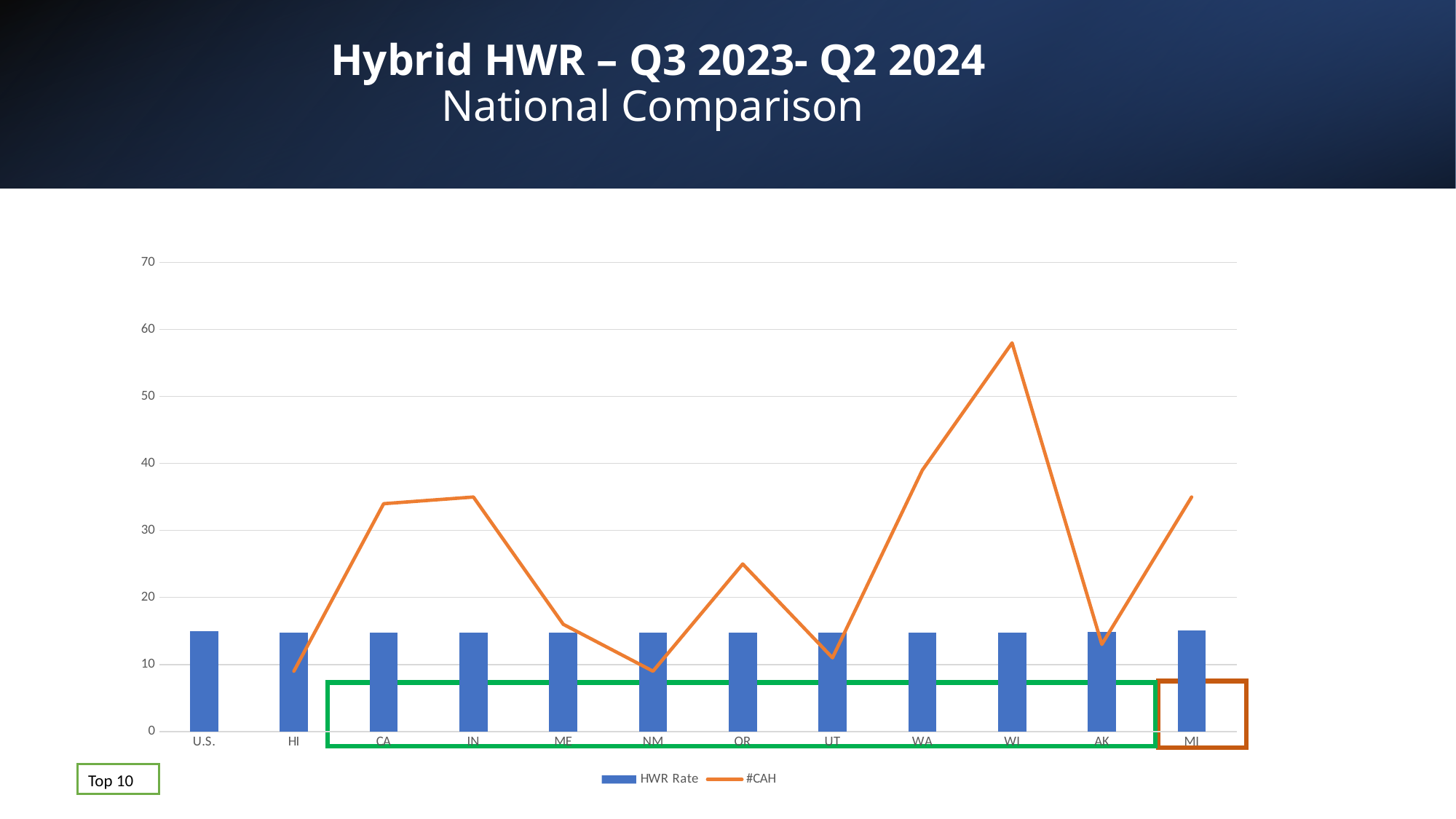
Is the #CAH value for CA greater or less than 30? greater Is the #CAH value for AK greater or less than 20? less What kind of chart is shown on the slide? A combination bar and line chart Which has a larger #CAH value, WI or AK? WI How many series does the legend list? 2 Which has a larger #CAH value, CA or ME? CA Is the #CAH value for UT greater or less than 20? less How many categories are shown along the x axis? 12 Which category has the highest #CAH value? WI Which series is drawn as an orange line? #CAH